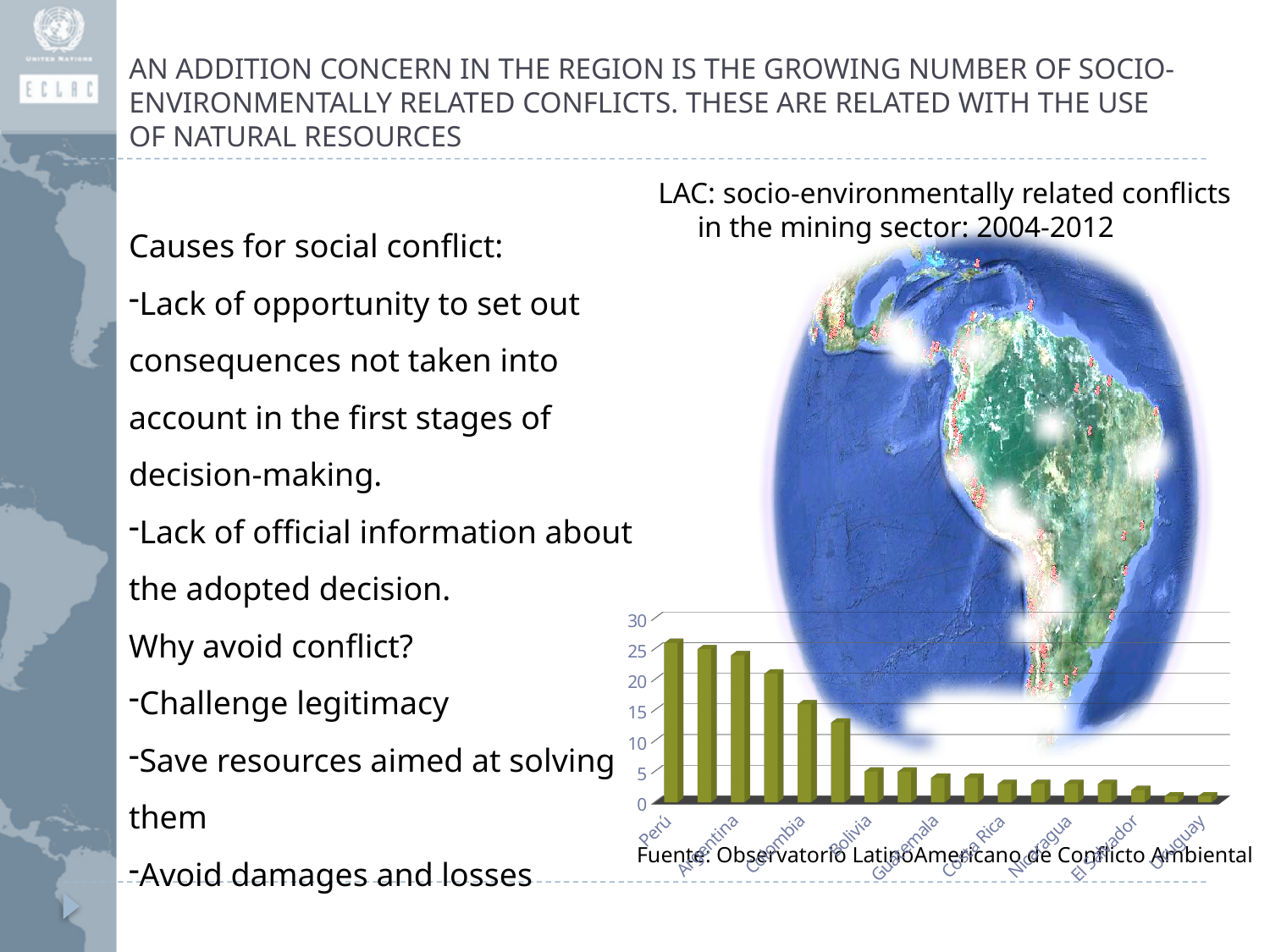
Is the value for Bolivia greater or less than 10? less Is the value for Uruguay greater or less than 5? less What kind of chart is shown on the slide? bar chart Is the value for Colombia greater or less than 10? greater Which has more conflicts, Argentina or Guatemala? Argentina What source is cited below the chart? Observatorio LatinoAmericano de Conflicto Ambiental What is the title of the chart? LAC: socio-environmentally related conflicts in the mining sector: 2004-2012 Which country has the highest number of conflicts in the chart? Perú Which has more conflicts, Perú or Uruguay? Perú Do the values rise or fall moving from left to right along the x axis? fall